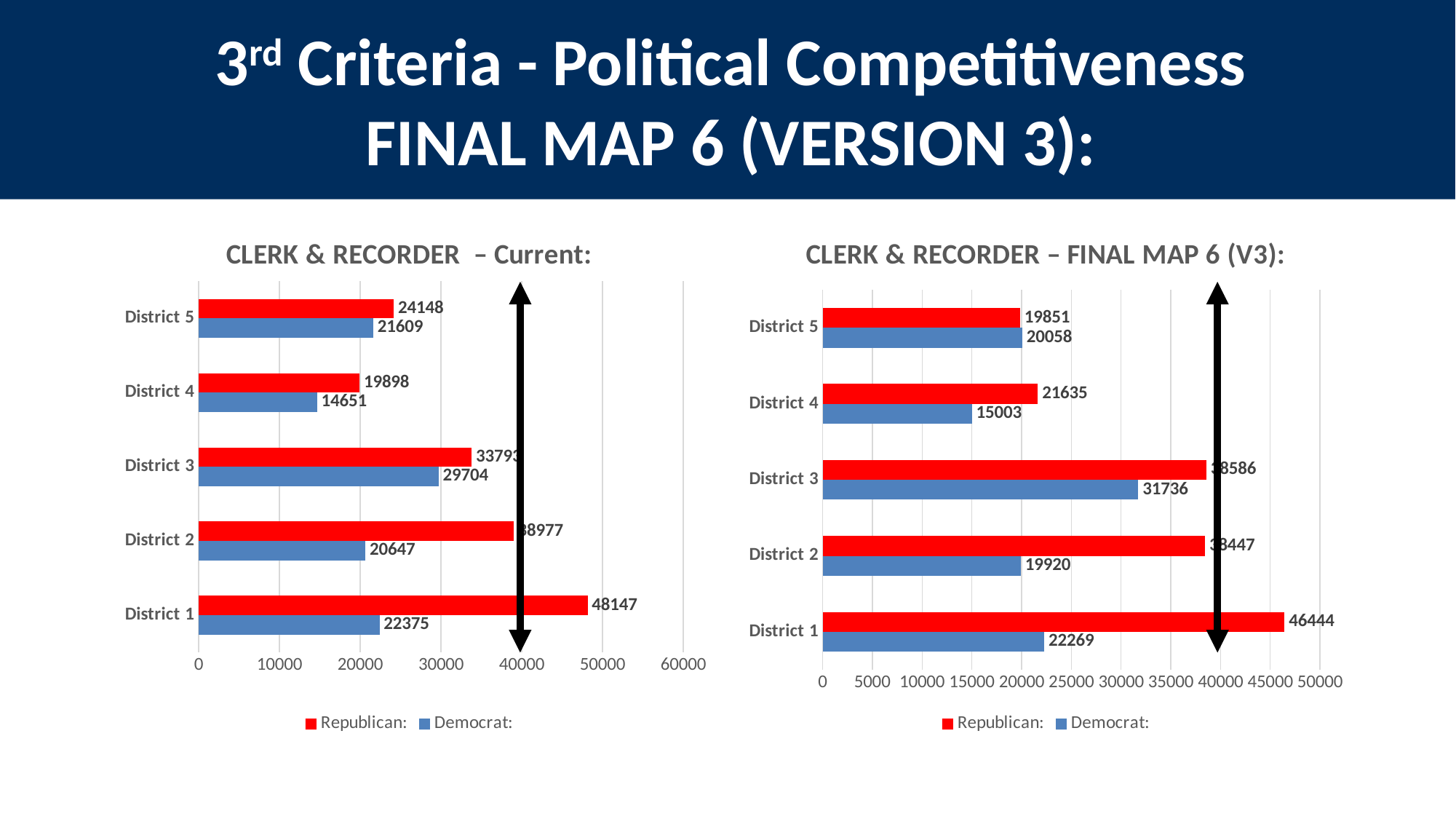
How many districts are shown in the CLERK & RECORDER – FINAL MAP 6 (V3) chart? 5 In the CLERK & RECORDER – FINAL MAP 6 (V3) chart, what is the difference between the Republican and Democrat values for District 4? 6632 In the CLERK & RECORDER – FINAL MAP 6 (V3) chart, what is the Democrat value for District 5? 20058 In the CLERK & RECORDER – Current chart, which district has the highest Republican value? District 1 In the CLERK & RECORDER – Current chart, is the Democrat value for District 3 greater or less than 20000? greater In the CLERK & RECORDER – Current chart, what is the Republican value for District 1? 48147 In the CLERK & RECORDER – FINAL MAP 6 (V3) chart, which district has the lowest Democrat value? District 4 In the CLERK & RECORDER – FINAL MAP 6 (V3) chart, which is larger for District 5, the Republican value or the Democrat value? Democrat How many series does the legend of the CLERK & RECORDER – Current chart list? 2 In the CLERK & RECORDER – Current chart, what is the Democrat value for District 4? 14651 In the CLERK & RECORDER – FINAL MAP 6 (V3) chart, what is the Republican value for District 4? 21635 In the CLERK & RECORDER – Current chart, what is the difference between the Republican and Democrat values for District 1? 25772